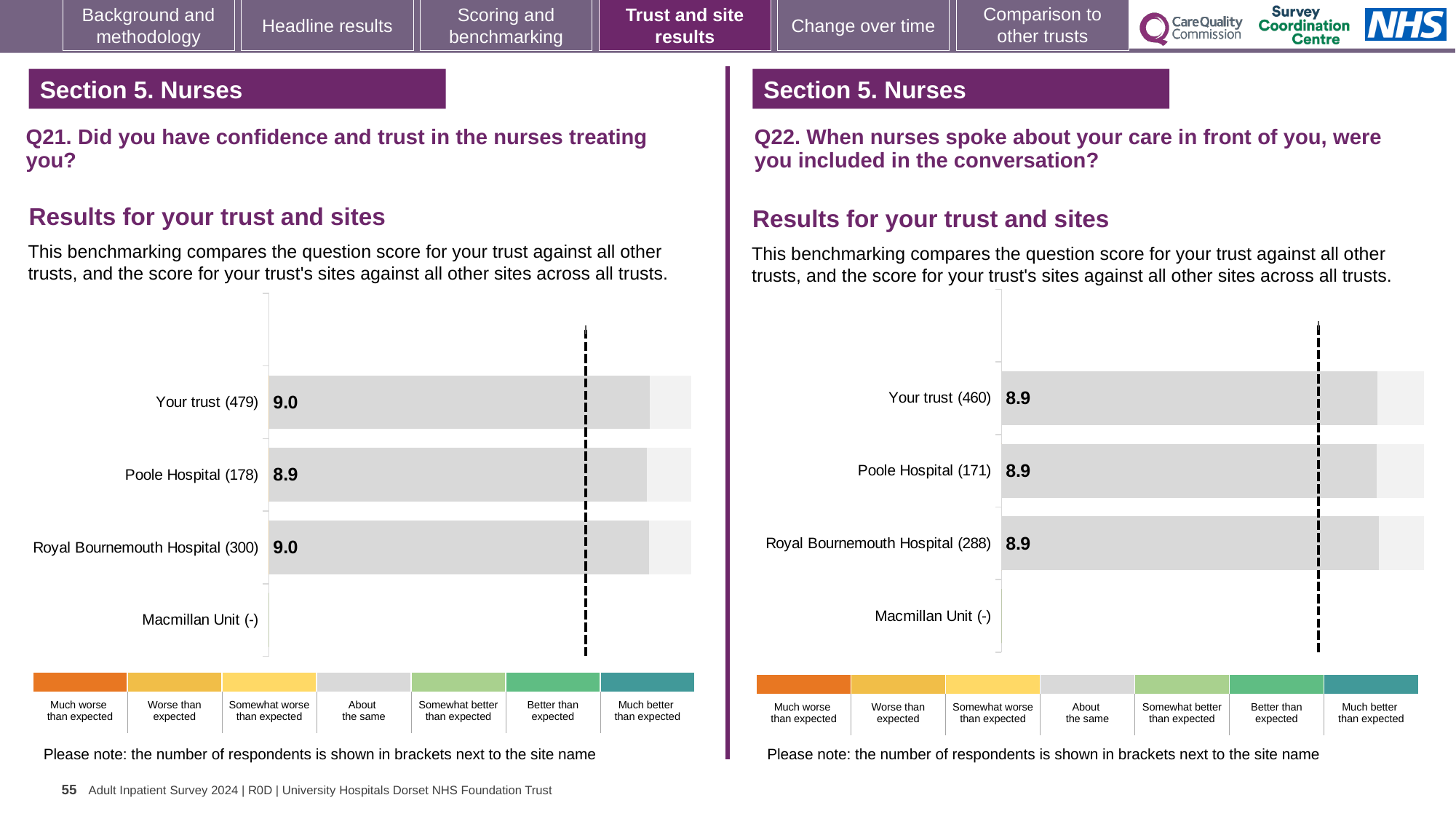
What kind of chart is the Q22 chart on the right? Bar chart In the Q22 chart on the right, what is the score for Your trust? 8.9 In the Q21 chart on the left, what is the score for Poole Hospital? 8.9 In the Q21 chart on the left, what is the score for Your trust? 9.0 In the Q21 chart on the left, what is the score for Royal Bournemouth Hospital? 9.0 In the Q21 chart on the left, what is the difference between the score for Your trust and the score for Poole Hospital? 0.1 In the Q21 chart on the left, which category has no score shown? Macmillan Unit In the Q22 chart on the right, what is the score for Royal Bournemouth Hospital? 8.9 How many site or trust categories are listed on the Q21 chart on the left? 4 In the Q22 chart on the right, how many respondents are shown in brackets for Your trust? 460 In the Q21 chart on the left, which has the lower score, Poole Hospital or Royal Bournemouth Hospital? Poole Hospital In the Q22 chart on the right, what is the difference between the score for Poole Hospital and the score for Royal Bournemouth Hospital? 0